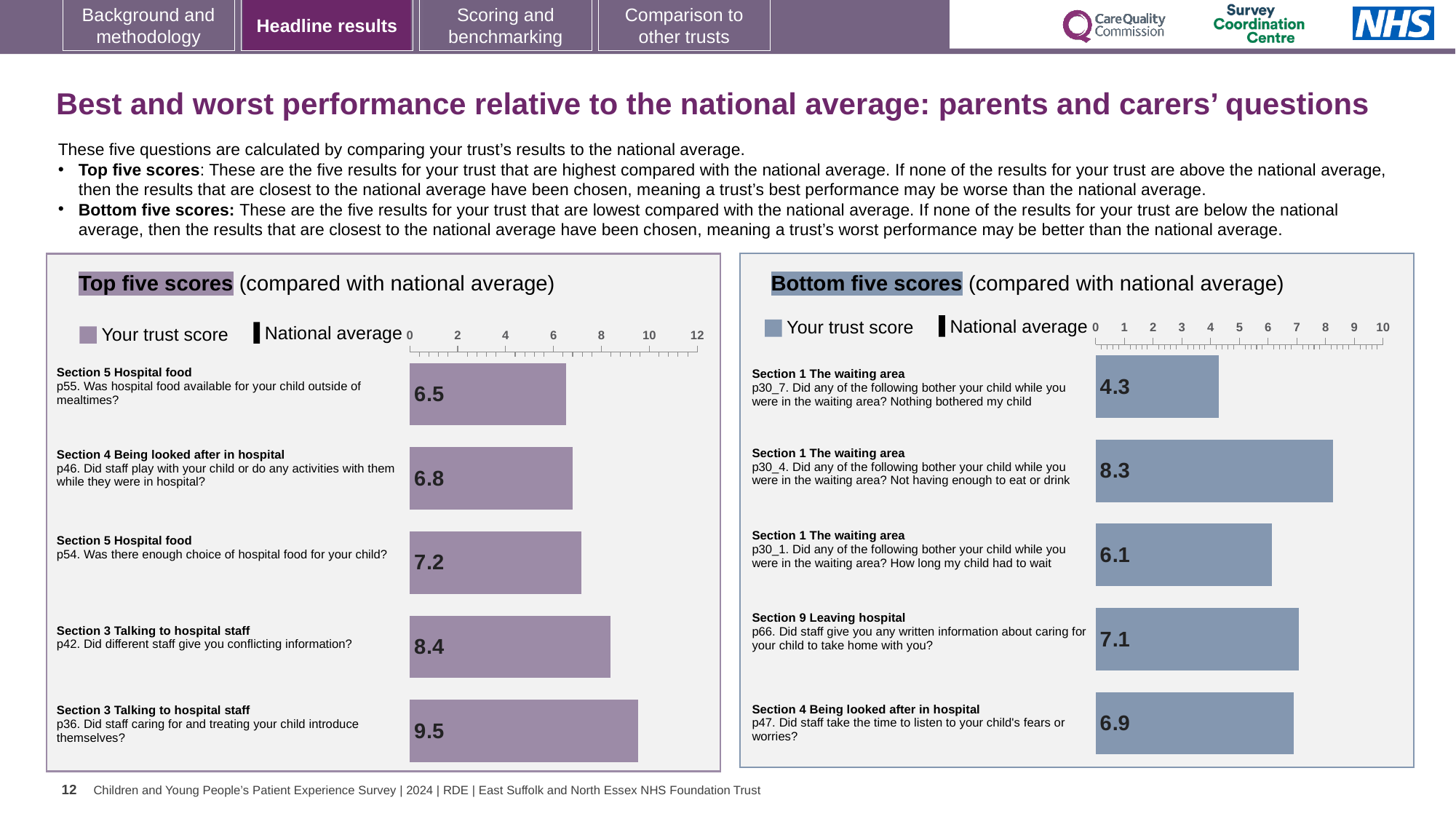
In the Bottom five scores chart, what is the trust score for p30_4 (Not having enough to eat or drink)? 8.3 In the Top five scores chart, how many questions are shown? 5 What type of chart is the Top five scores chart? Bar chart In the Top five scores chart, what is the trust score for p55 (Was hospital food available for your child outside of mealtimes?)? 6.5 How many entries does the legend of the Bottom five scores chart list? 2 In the Bottom five scores chart, what is the trust score for p66 (Did staff give you any written information about caring for your child to take home with you?)? 7.1 In the Bottom five scores chart, which question has the lowest trust score? p30_7. Did any of the following bother your child while you were in the waiting area? Nothing bothered my child In the Bottom five scores chart, what is the difference between the trust scores for p30_4 and p30_7? 4.0 In the Top five scores chart, which question has the highest trust score? p36. Did staff caring for and treating your child introduce themselves? In the Top five scores chart, what is the trust score for p36 (Did staff caring for and treating your child introduce themselves?)? 9.5 In the Top five scores chart, what is the difference between the trust scores for p42 and p54? 1.2 In the Bottom five scores chart, which has the larger trust score: p30_1 or p47? p47